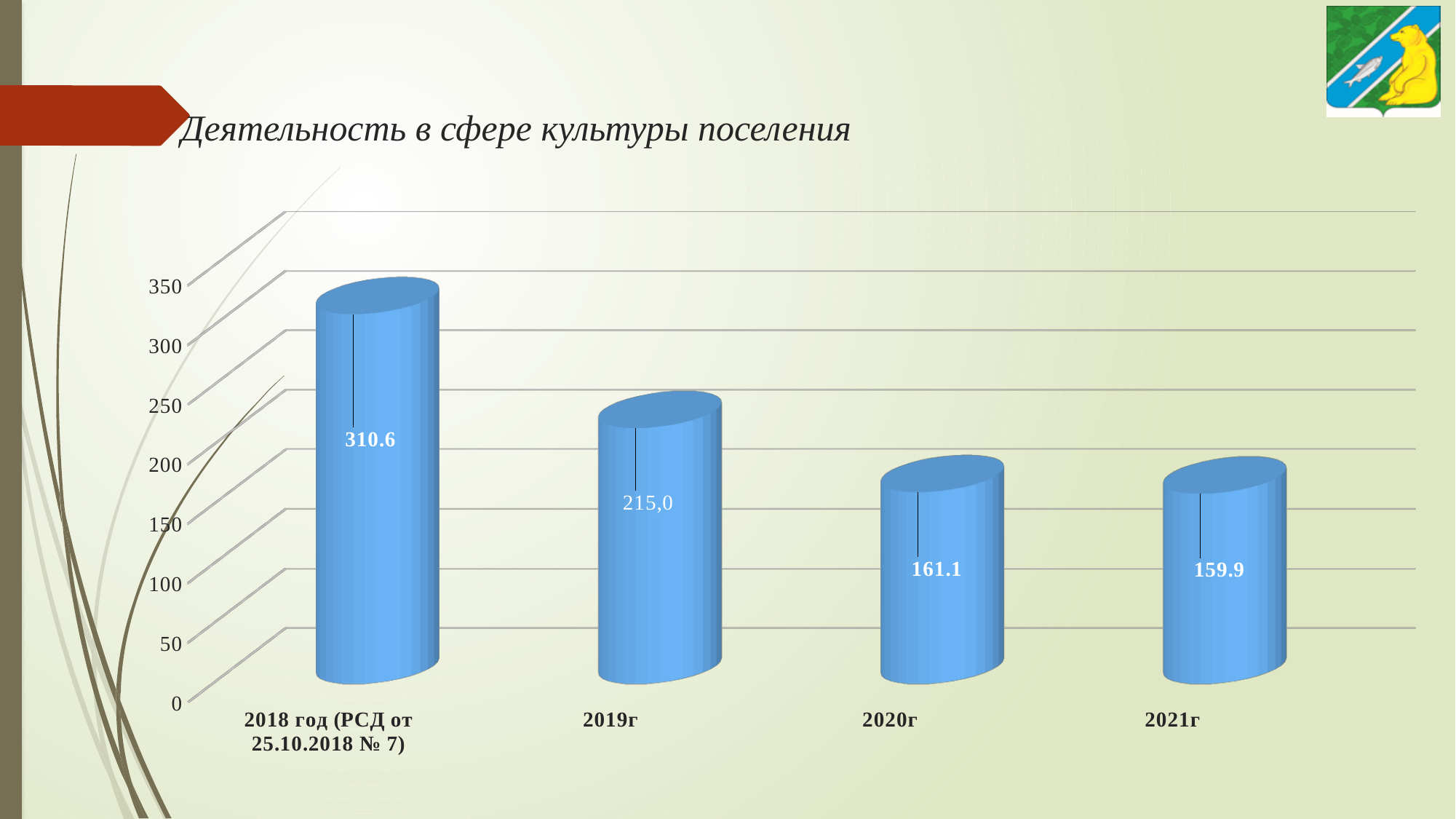
What is the value for 2021г? 159.9 Which is larger, the value for 2019г or the value for 2020г? 2019г How many categories are shown on the x axis? 4 What is the value for 2018 год (РСД от 25.10.2018 № 7)? 310.6 What is the difference between the values for 2020г and 2021г? 1.2 Which category has the highest value? 2018 год (РСД от 25.10.2018 № 7) Which category has the lowest value? 2021г What is the value for 2019г? 215,0 Is the value for 2019г greater or less than 200? greater What kind of chart is shown on the slide? bar chart Do the values rise or fall from 2018 to 2021 along the x axis? fall What is the difference between the values for 2018 год (РСД от 25.10.2018 № 7) and 2019г? 95.6